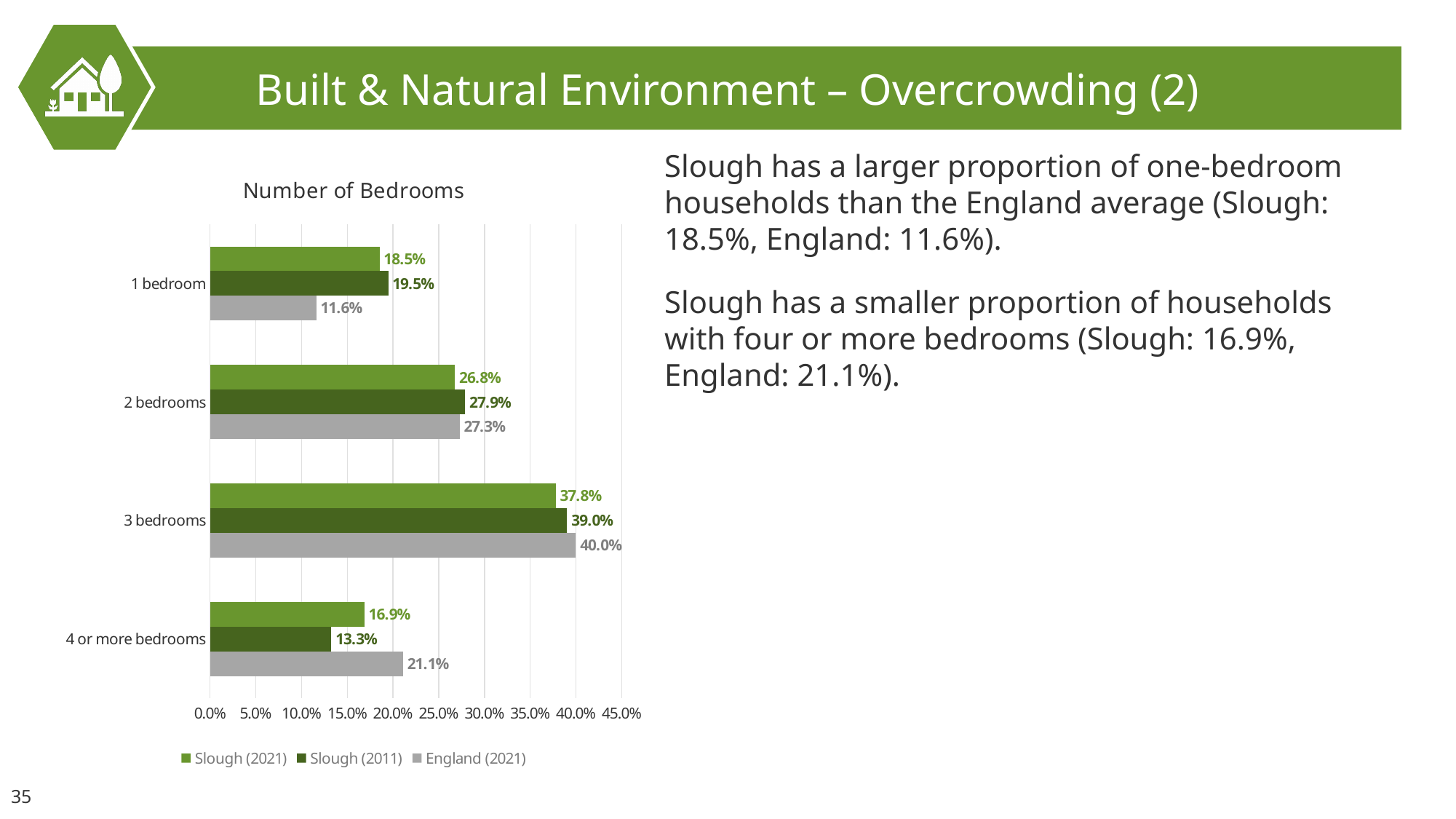
Which is larger for 4 or more bedrooms: Slough (2021) or England (2021)? England (2021) Is the England (2021) value for 3 bedrooms greater or less than 35.0%? greater How many bedroom categories are shown on the chart? 4 Which bedroom category has the lowest England (2021) value? 1 bedroom What is the difference between the Slough (2021) and England (2021) values for 1 bedroom? 6.9% What kind of chart is shown on the slide? Bar chart What is the England (2021) value for 4 or more bedrooms? 21.1% What is the title of the chart? Number of Bedrooms How many series does the legend list? 3 What is the Slough (2021) value for 1 bedroom? 18.5% Which bedroom category has the highest Slough (2021) value? 3 bedrooms What is the Slough (2011) value for 3 bedrooms? 39.0%